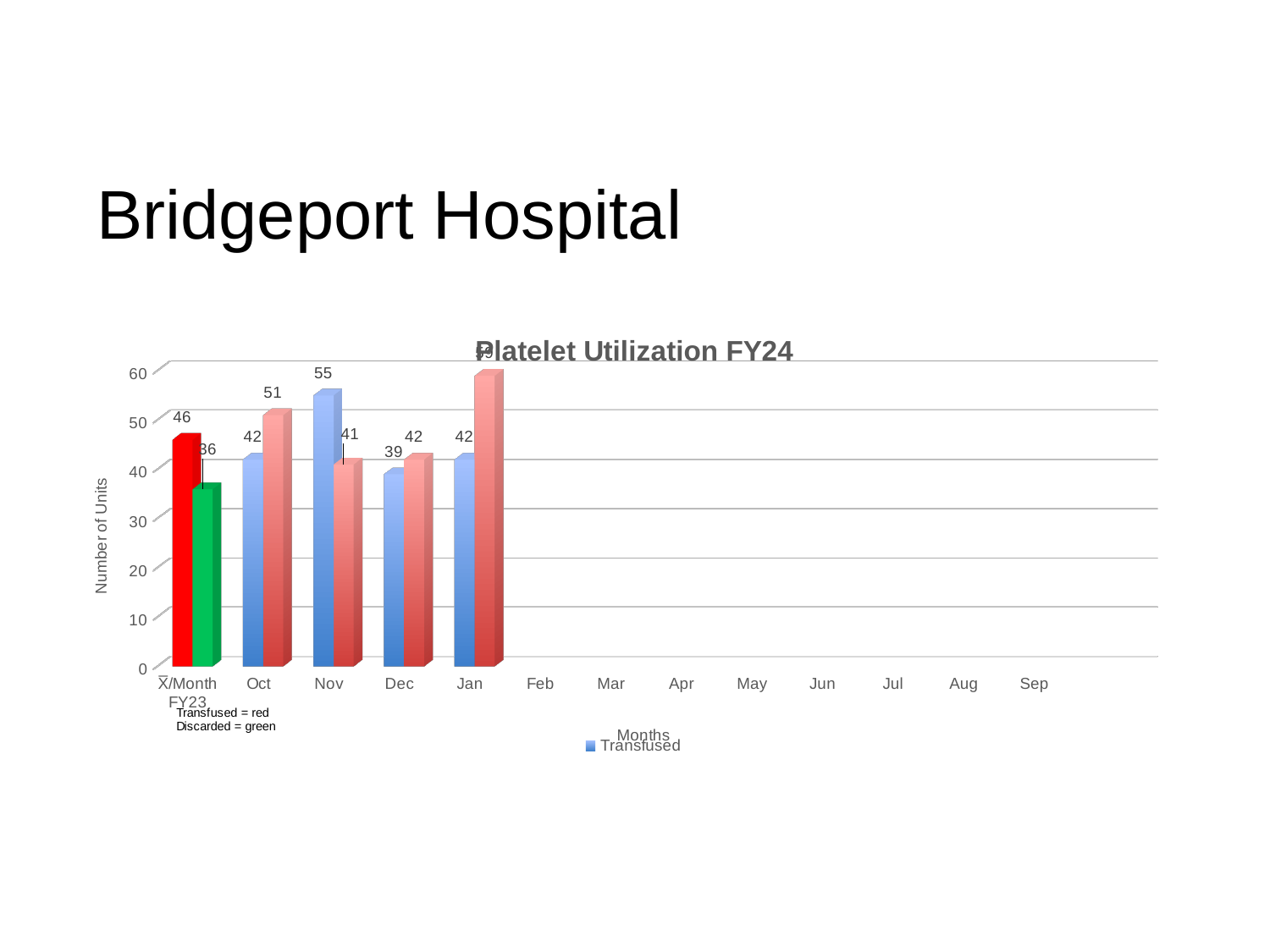
What is the Transfused value for Oct? 42 What is the Discarded value for Oct? 51 Is the Discarded value for Jan greater or less than 50? greater What is the title of the chart? Platelet Utilization FY24 Which is larger for Dec, the Transfused value or the Discarded value? Discarded What is the difference between the Transfused and Discarded values for Nov? 14 What is the Discarded value for Nov? 41 What is the Transfused value for Nov? 55 What is the label on the vertical axis? Number of Units What type of chart is shown on the slide? bar chart What is the Transfused value for Dec? 39 Which month from Oct to Jan has the highest Transfused value? Nov